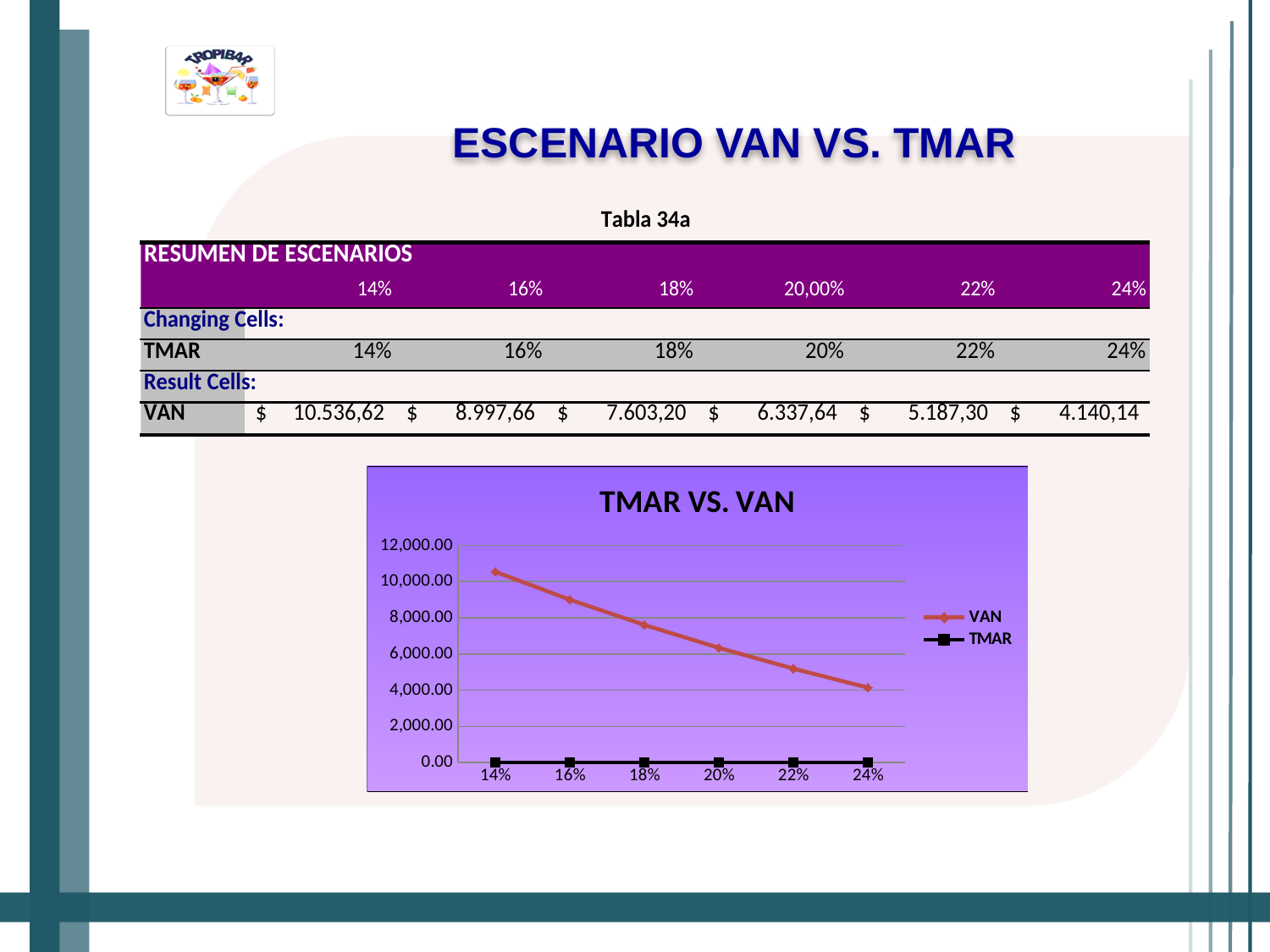
In the "TMAR VS. VAN" chart, is the VAN value at 18% greater or less than 8,000.00? less In the "TMAR VS. VAN" chart, which is larger: the VAN value at 16% or the VAN value at 20%? 16% In the "TMAR VS. VAN" chart, is the VAN value at 14% greater or less than 10,000.00? greater What kind of chart is the "TMAR VS. VAN" chart? line chart In the "TMAR VS. VAN" chart, is the VAN value at 22% greater or less than 6,000.00? less In the "TMAR VS. VAN" chart, does the VAN series rise or fall as TMAR increases from 14% to 24%? fall In the "TMAR VS. VAN" chart, at which TMAR value is VAN lowest? 24% What is the title of the chart on the slide? TMAR VS. VAN According to the table on the slide, what is the VAN value when TMAR is 18%? $ 7.603,20 How many TMAR categories are shown on the x axis of the "TMAR VS. VAN" chart? 6 In the "TMAR VS. VAN" chart, at which TMAR value is VAN highest? 14% How many series does the legend of the "TMAR VS. VAN" chart list? 2